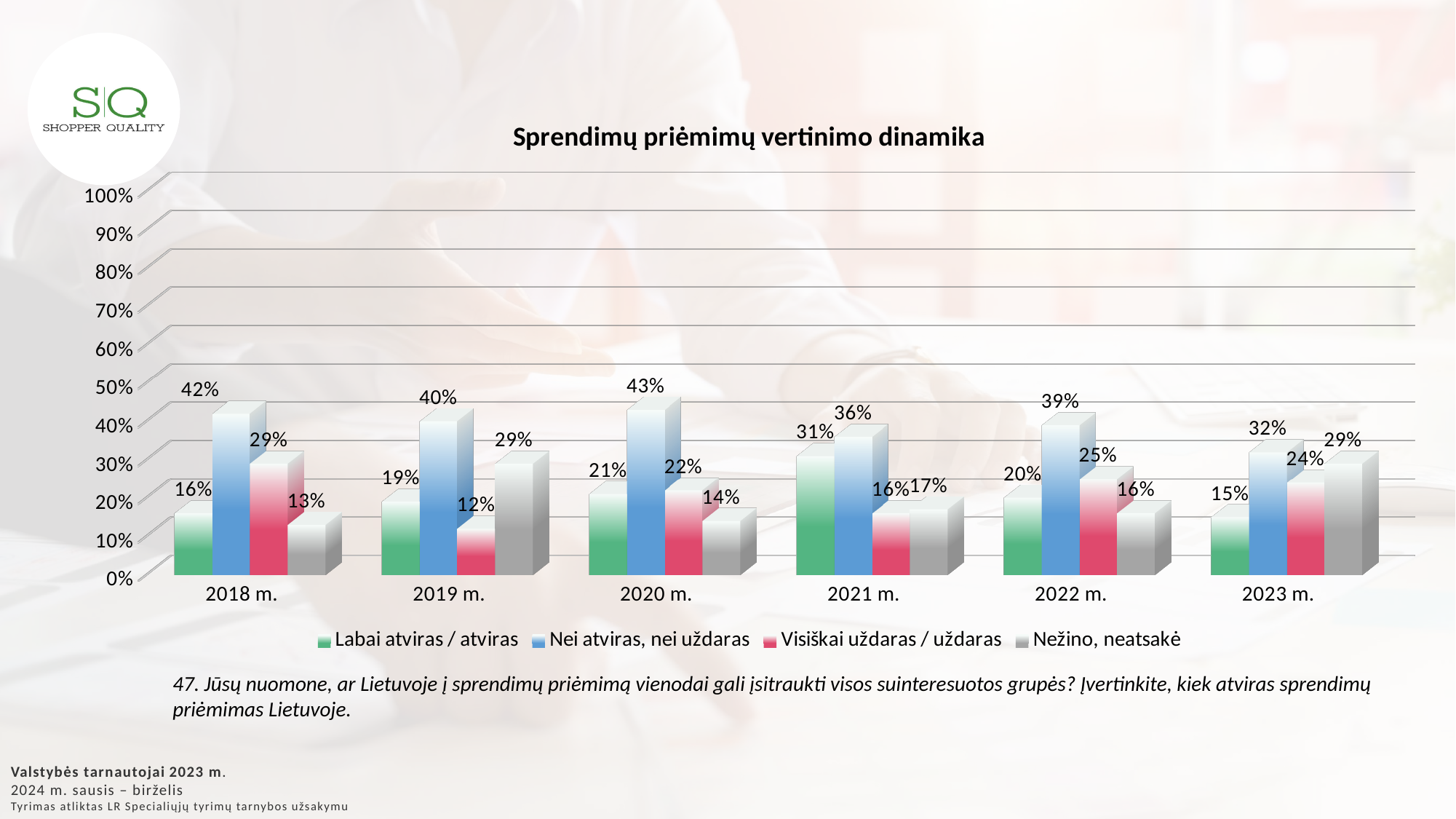
What is the value for "Labai atviras / atviras" in 2021 m.? 31% In which year is the "Nei atviras, nei uždaras" value highest? 2020 m. In which year is the "Labai atviras / atviras" value lowest? 2023 m. What is the value for "Visiškai uždaras / uždaras" in 2019 m.? 12% How many series does the legend list? 4 What is the title of the chart? Sprendimų priėmimų vertinimo dinamika What is the value for "Nežino, neatsakė" in 2023 m.? 29% What is the difference between the "Nei atviras, nei uždaras" value in 2018 m. and in 2023 m.? 10% How many years are shown on the x axis? 6 Which is larger in 2022 m.: "Visiškai uždaras / uždaras" or "Nežino, neatsakė"? Visiškai uždaras / uždaras What kind of chart is shown on the slide? Bar chart What is the value for "Nei atviras, nei uždaras" in 2018 m.? 42%